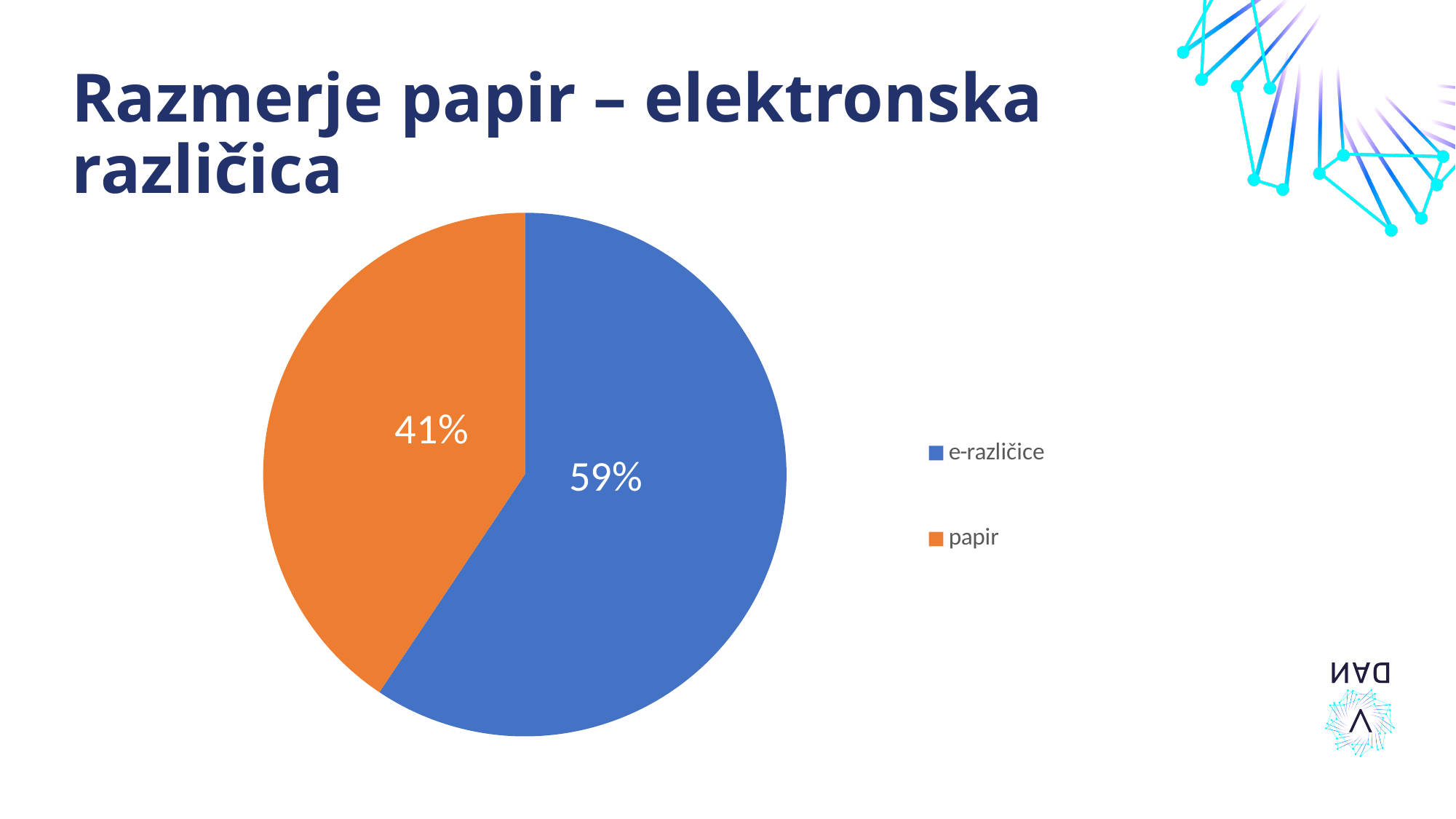
What colour is the slice for papir? orange What share of the pie does papir have? 41% Which category has the largest slice of the pie? e-različice What share of the pie does e-različice have? 59% Which category has the smallest slice of the pie? papir How many slices does the pie chart have? 2 Which is larger, the share for papir or the share for e-različice? e-različice How many entries does the legend list? 2 What kind of chart is shown on the slide? pie chart What is the difference in percentage points between e-različice and papir? 18 What is the title of the slide? Razmerje papir – elektronska različica